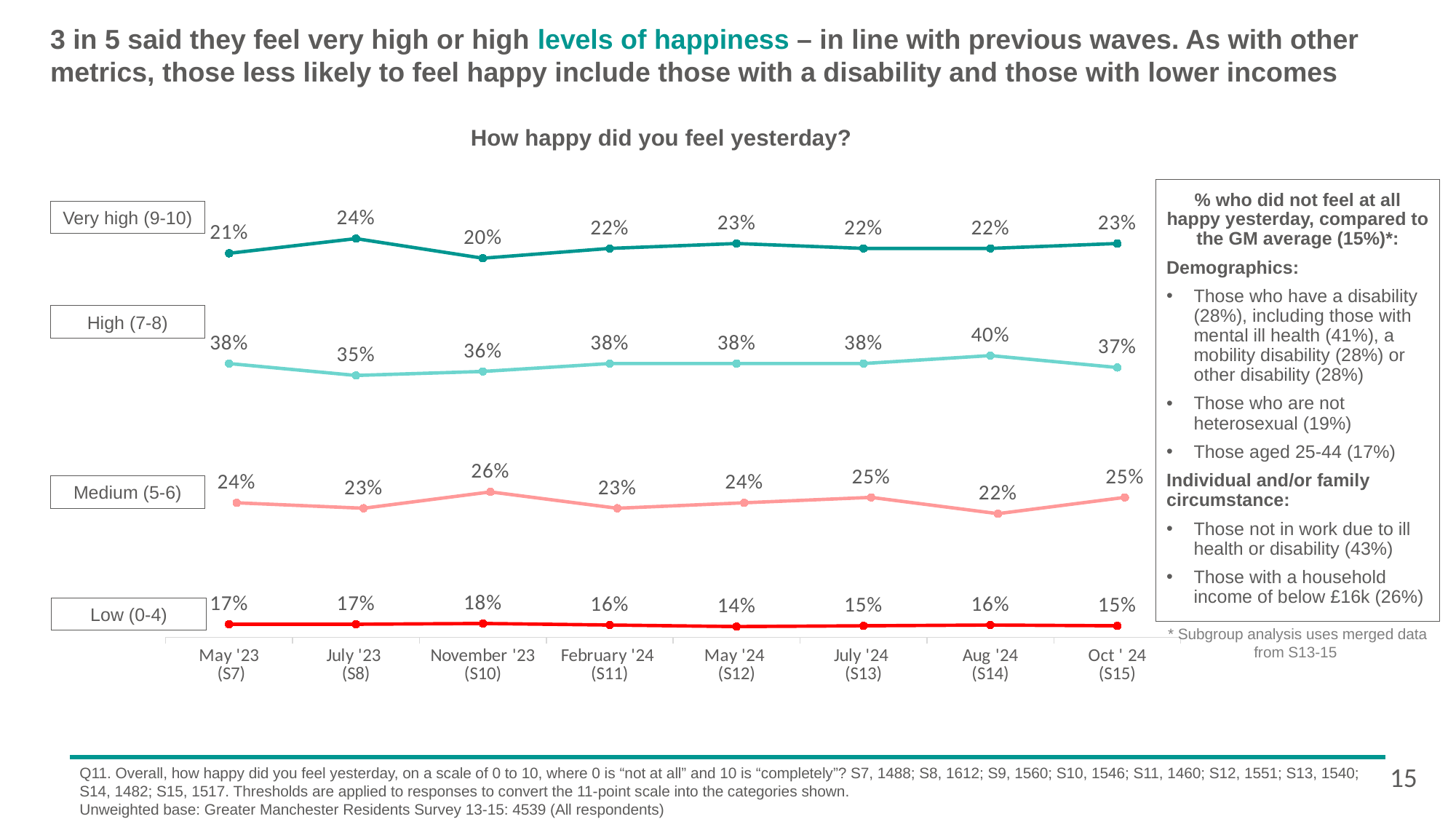
How many happiness categories (series) are plotted on the chart? 4 What type of chart is used to show happiness levels over time? Line chart What percentage of respondents reported High (7-8) happiness in Aug '24 (S14)? 40% In which wave was the Low (0-4) share at its lowest? May '24 (S12) What percentage of respondents reported Low (0-4) happiness in May '24 (S12)? 14% Was the Medium (5-6) share higher in November '23 (S10) or February '24 (S11)? November '23 (S10) By how many percentage points did the High (7-8) share fall from Aug '24 (S14) to Oct '24 (S15)? 3 percentage points How many survey waves are plotted along the x axis? 8 What is the total of the four happiness category percentages for Oct '24 (S15)? 100% What percentage of respondents reported Very high (9-10) happiness in November '23 (S10)? 20% In which wave was the Very high (9-10) share at its highest? July '23 (S8) What is the title of the chart? How happy did you feel yesterday?